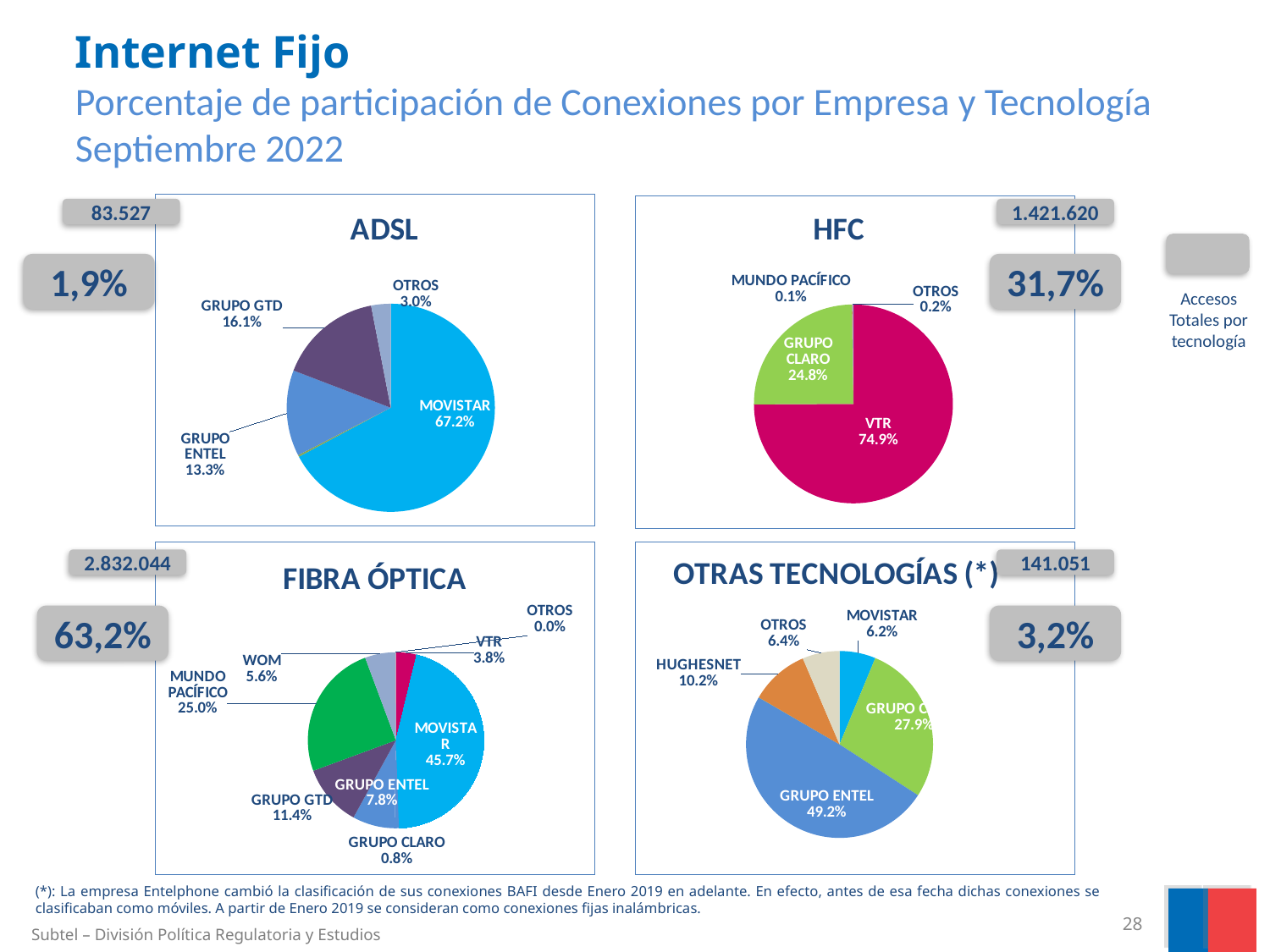
In the ADSL chart, what share does MOVISTAR hold? 67.2% In the FIBRA ÓPTICA chart, which is larger, GRUPO GTD or GRUPO ENTEL? GRUPO GTD How many slices are labelled in the HFC chart? 4 In the ADSL chart, which company has the largest slice? MOVISTAR In the OTRAS TECNOLOGÍAS (*) chart, what share does HUGHESNET hold? 10.2% How many slices are labelled in the FIBRA ÓPTICA chart? 8 What kind of chart is used for the HFC data? Pie chart In the FIBRA ÓPTICA chart, what share does MUNDO PACÍFICO hold? 25.0% In the OTRAS TECNOLOGÍAS (*) chart, which company has the largest slice? GRUPO ENTEL In the HFC chart, which company has the smallest slice? MUNDO PACÍFICO In the ADSL chart, what is the difference between GRUPO GTD and GRUPO ENTEL? 2.8% In the HFC chart, what share does GRUPO CLARO hold? 24.8%